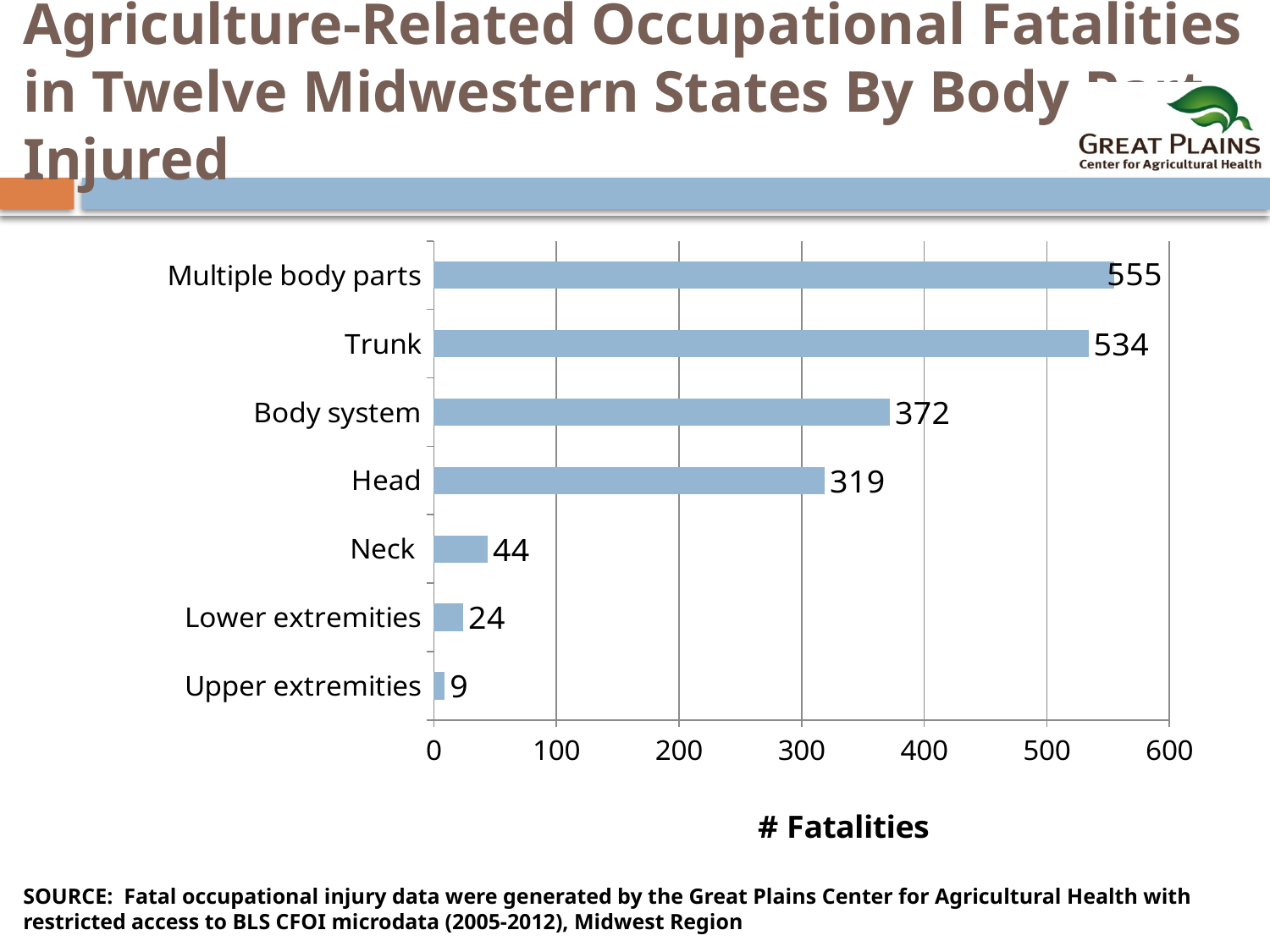
What is the label of the horizontal axis? # Fatalities Which has more fatalities, Neck or Lower extremities? Neck What is the number of fatalities for Head? 319 What is the difference in fatalities between Multiple body parts and Trunk? 21 How many body part categories are shown in the chart? 7 What value is shown for Lower extremities? 24 Which body part category has the lowest number of fatalities? Upper extremities How many fatalities are shown for Trunk? 534 Which body part category has the highest number of fatalities? Multiple body parts What is the difference in fatalities between Body system and Head? 53 What kind of chart is shown on the slide? Bar chart Is the value for Body system greater or less than 400? less